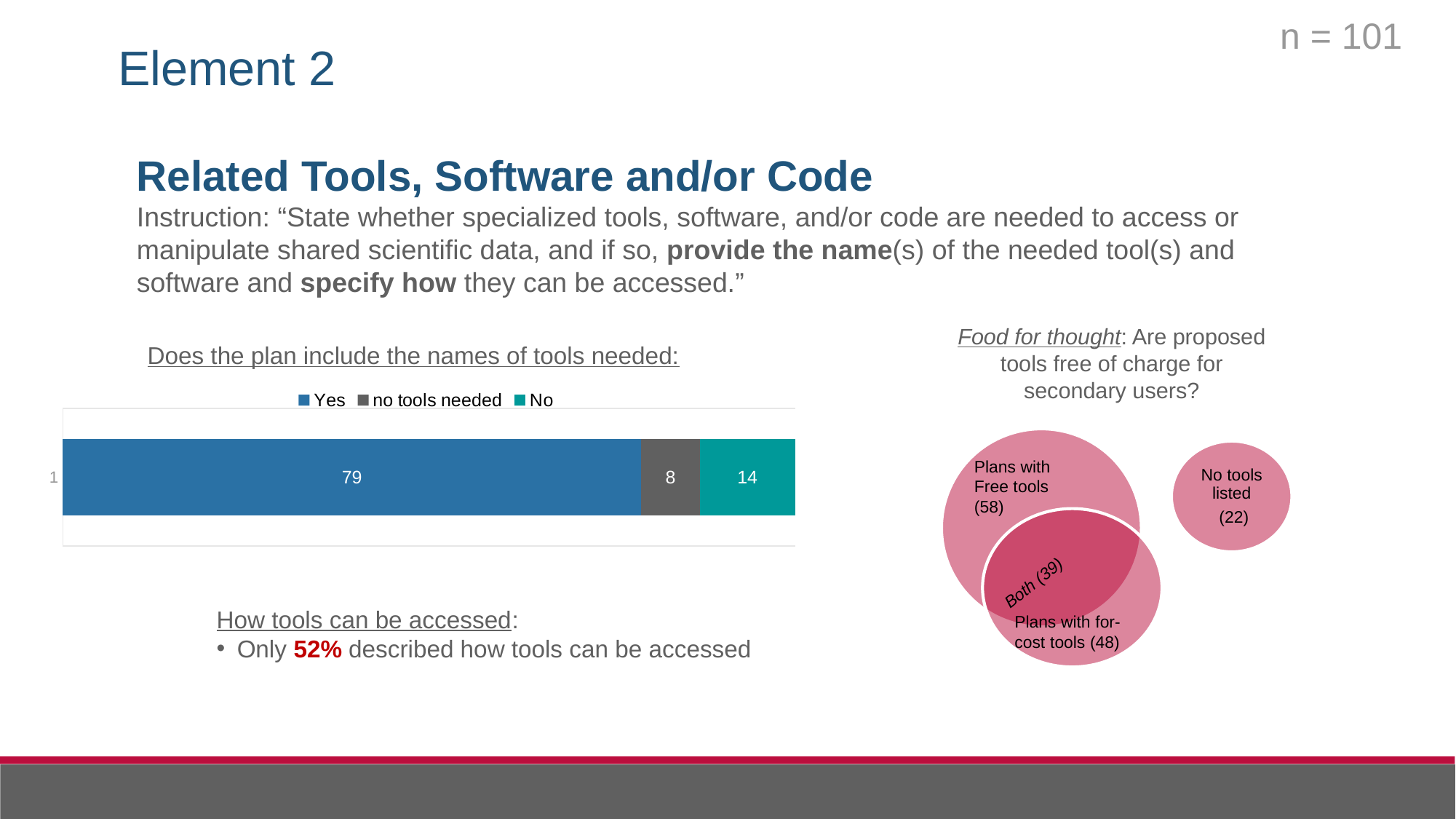
In the bar chart 'Does the plan include the names of tools needed', what is the value for Yes? 79 In the bar chart 'Does the plan include the names of tools needed', what is the total of the stacked bar? 101 In the bar chart 'Does the plan include the names of tools needed', what is the value for 'no tools needed'? 8 In the bar chart 'Does the plan include the names of tools needed', what is the value for No? 14 In the bar chart 'Does the plan include the names of tools needed', which is larger: No or 'no tools needed'? No In the bar chart 'Does the plan include the names of tools needed', which series has the smallest value? no tools needed In the 'Food for thought' diagram on the right, how many plans are in the 'Both' overlap? 39 In the bar chart 'Does the plan include the names of tools needed', what colour is the Yes segment? Blue What kind of chart is used for 'Does the plan include the names of tools needed'? Stacked bar chart In the bar chart 'Does the plan include the names of tools needed', which series has the largest value? Yes In the bar chart 'Does the plan include the names of tools needed', what is the difference between the Yes value and the No value? 65 How many series does the legend of the bar chart 'Does the plan include the names of tools needed' list? 3